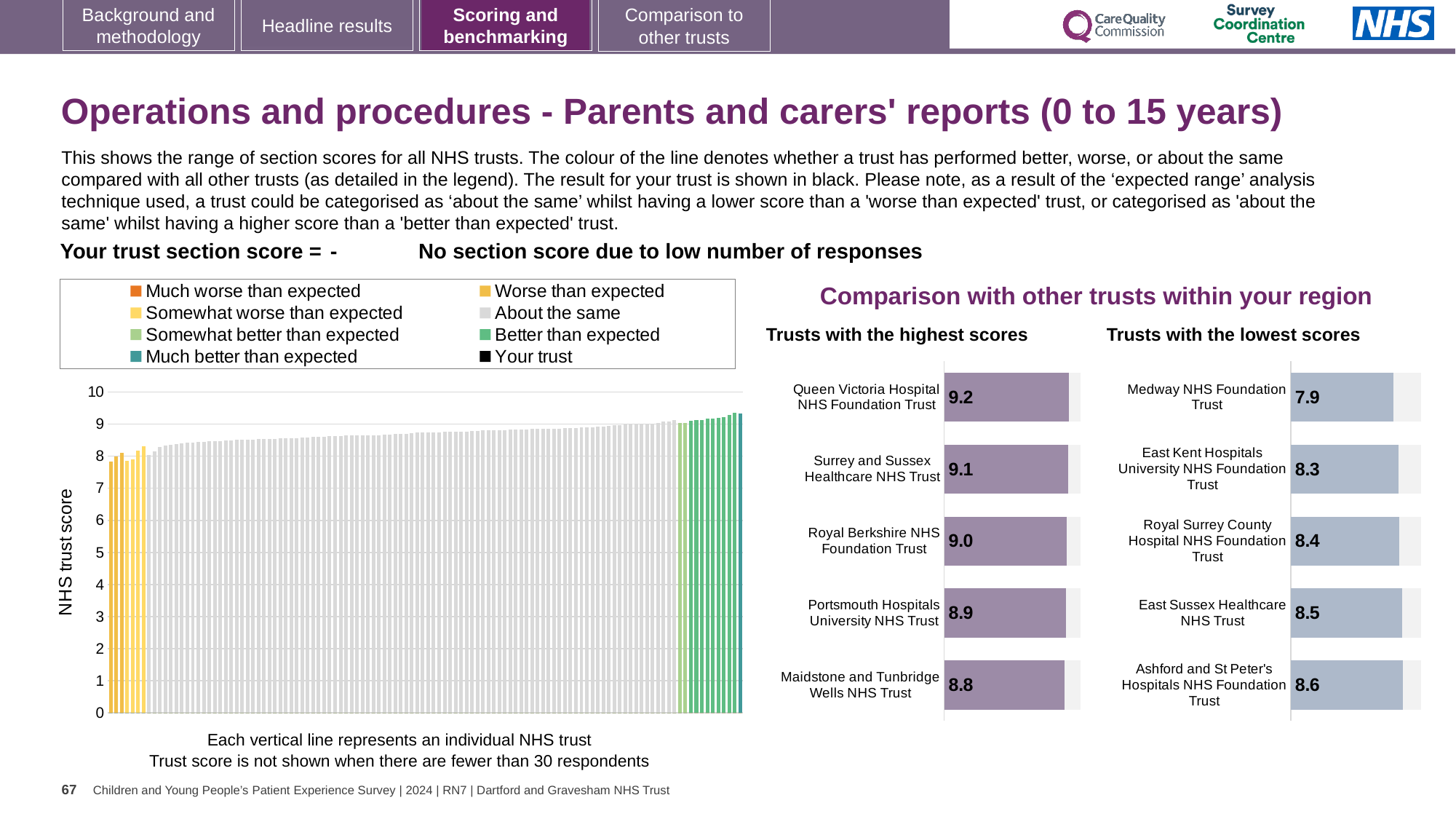
In the 'Trusts with the highest scores' chart, which trust has the lowest score? Maidstone and Tunbridge Wells NHS Trust What is the difference between the score for Queen Victoria Hospital NHS Foundation Trust in the 'highest scores' chart and the score for Medway NHS Foundation Trust in the 'lowest scores' chart? 1.3 In the 'Trusts with the lowest scores' chart, what is the score for Ashford and St Peter's Hospitals NHS Foundation Trust? 8.6 How many trusts are shown in the 'Trusts with the highest scores' chart? 5 How many entries does the legend above the large chart on the left list? 8 In the 'Trusts with the highest scores' chart, what is the score for Queen Victoria Hospital NHS Foundation Trust? 9.2 In the 'Trusts with the lowest scores' chart, which is larger: the score for East Kent Hospitals University NHS Foundation Trust or the score for East Sussex Healthcare NHS Trust? East Sussex Healthcare NHS Trust In the 'Trusts with the lowest scores' chart, which trust has the highest score? Ashford and St Peter's Hospitals NHS Foundation Trust In the 'Trusts with the lowest scores' chart, what is the score for Medway NHS Foundation Trust? 7.9 In the 'Trusts with the highest scores' chart, what is the score for Royal Berkshire NHS Foundation Trust? 9.0 What kind of chart is the large chart on the left showing NHS trust scores? Bar chart In the large chart on the left, do the bar values rise or fall from left to right along the x axis? Rise